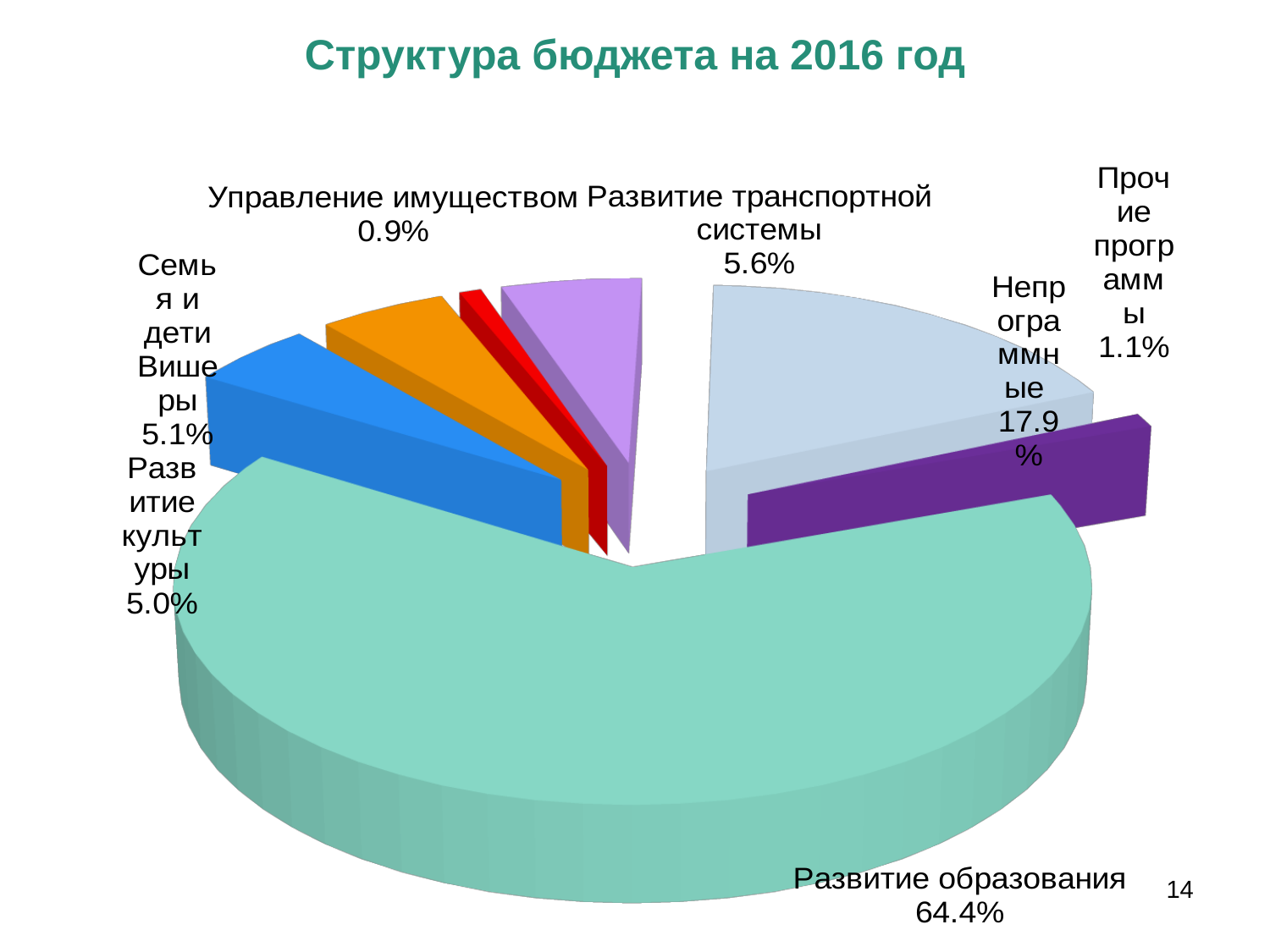
What is the difference between the shares of Развитие образования and Непрограммные? 46.5% Which category has the largest share of the budget? Развитие образования What share of the budget goes to Управление имуществом? 0.9% Which category has the smallest share of the budget? Управление имуществом What is the title of the chart? Структура бюджета на 2016 год What share of the budget goes to Развитие образования? 64.4% What share of the budget goes to Развитие транспортной системы? 5.6% What kind of chart is shown on the slide? pie chart What share of the budget goes to Прочие программы? 1.1% What share of the budget is Непрограммные? 17.9% How many categories are shown in the pie chart? 7 Which is larger, the share for Развитие транспортной системы or the share for Развитие культуры? Развитие транспортной системы